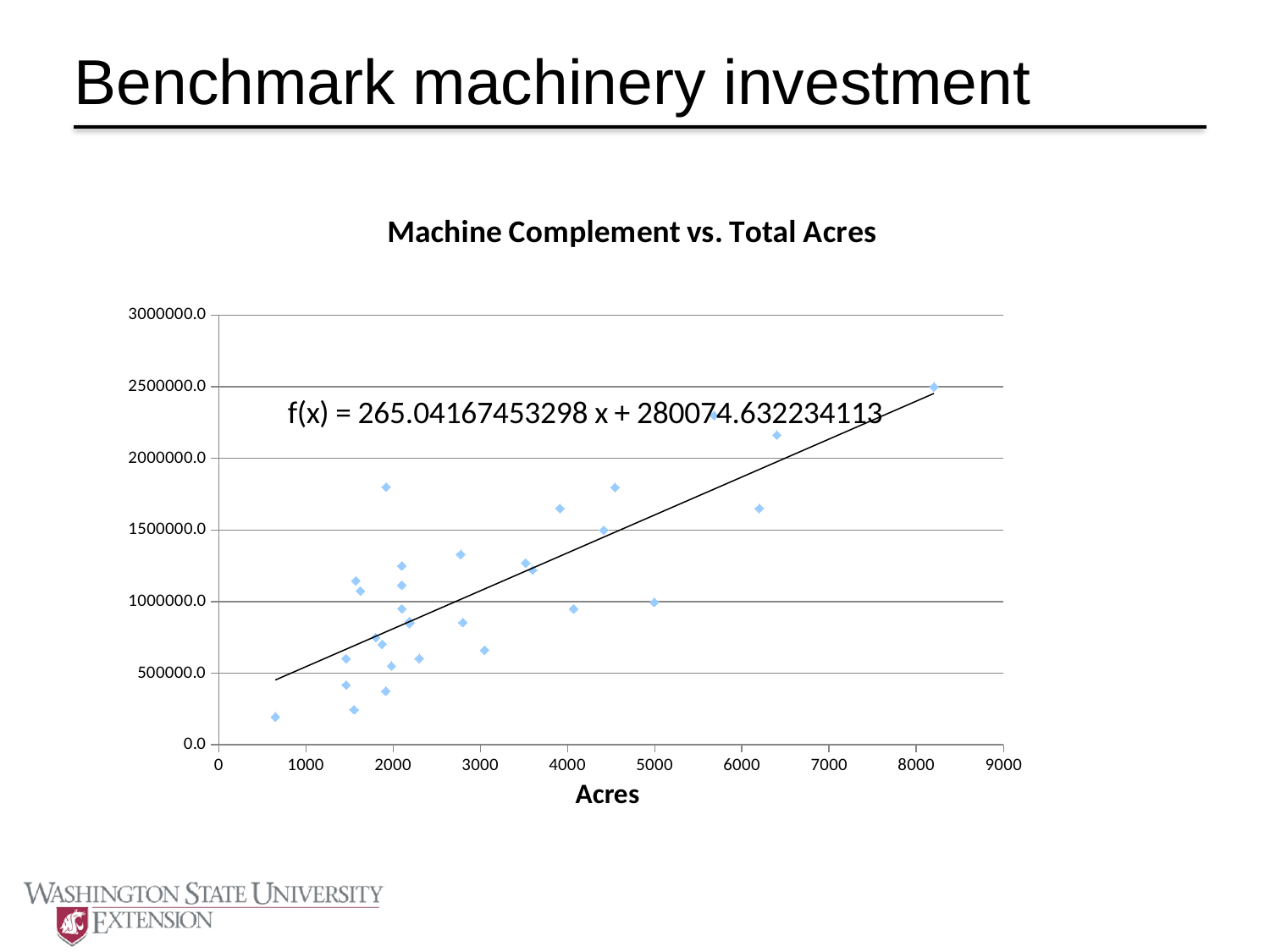
What kind of chart is shown on the slide? scatter chart What is the full trendline equation printed on the chart? f(x) = 265.04167453298 x + 280074.632234113 What is the title of the chart? Machine Complement vs. Total Acres What is the intercept of the trendline equation shown on the chart? 280074.632234113 Is the y value of the highest plotted point greater or less than 2000000.0? greater Is the acres value of the leftmost plotted point greater or less than 1000? less Is the slope of the trendline positive or negative? positive What is the label on the x axis of the chart? Acres Is the y value of the lowest plotted point greater or less than 500000.0? less Do the plotted values generally rise or fall as acres increase along the x axis? rise What is the slope of the trendline equation shown on the chart? 265.04167453298